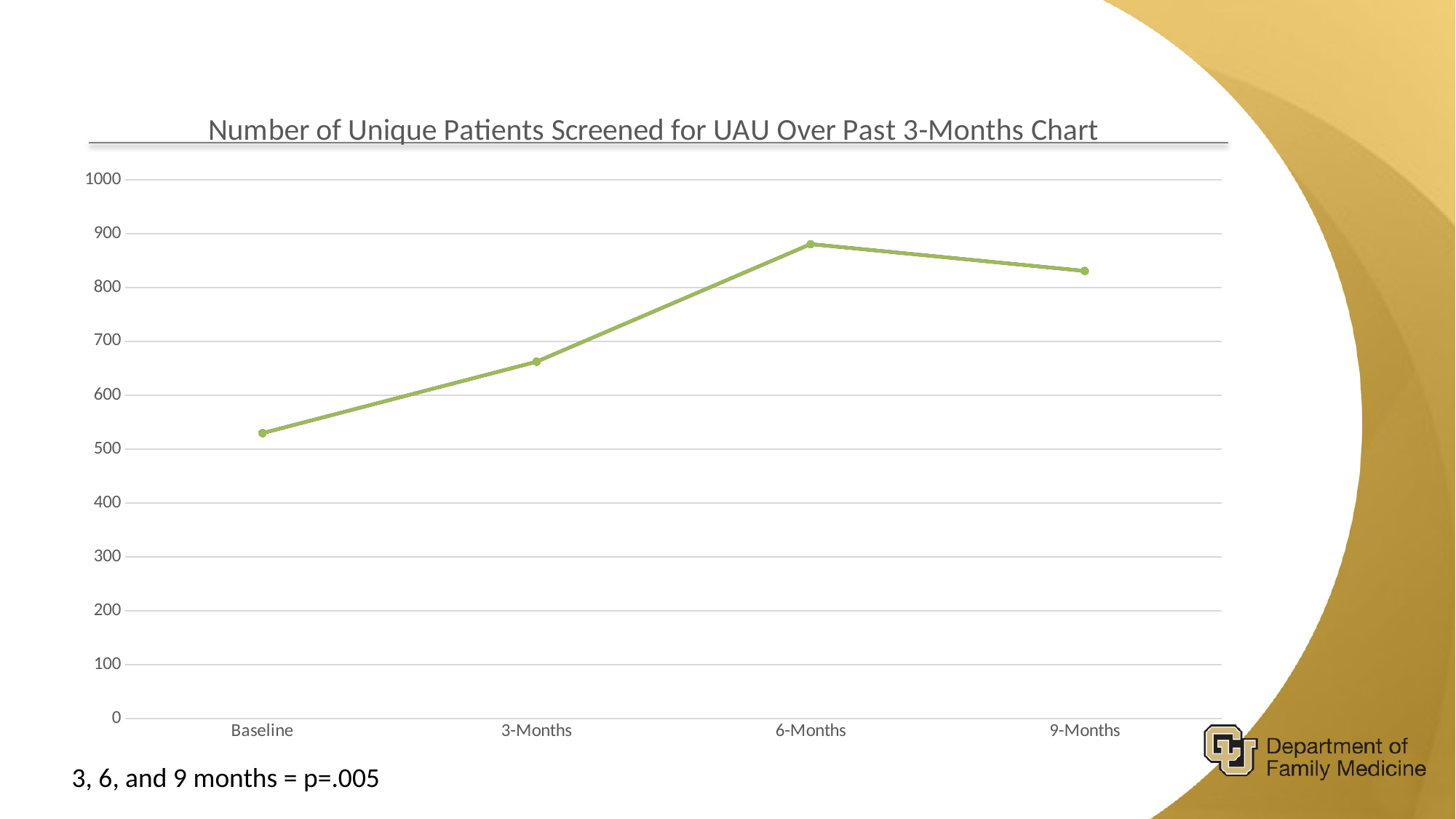
At which time point is the number of unique patients screened lowest? Baseline Does the line rise or fall between 6-Months and 9-Months? fall Does the line rise or fall between Baseline and 6-Months? rise Which is larger, the value at 3-Months or the value at 9-Months? 9-Months What kind of chart is shown on the slide? line chart Is the value at 3-Months greater or less than 700? less At which time point is the number of unique patients screened highest? 6-Months What is the title of the chart? Number of Unique Patients Screened for UAU Over Past 3-Months Chart Is the value at 6-Months greater or less than 800? greater How many time points are plotted on the x axis? 4 Is the value at 9-Months greater or less than 900? less